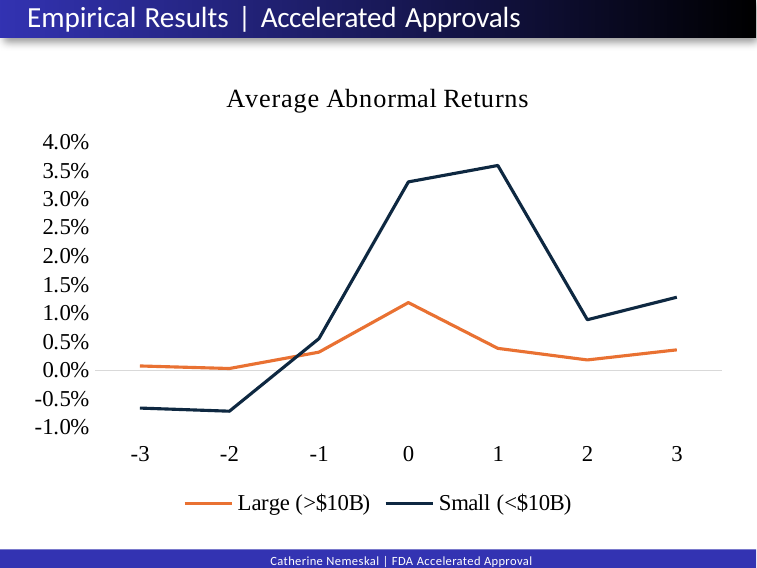
How many series does the legend list? 2 What kind of chart is shown on the slide? line chart Is the value for Large (>$10B) at x = 0 greater or less than 1.0%? greater How many points are plotted along the x axis for each series? 7 At which x-axis value does the Small (<$10B) series reach its highest point? 1 Does the Small (<$10B) series rise or fall between x = -2 and x = 1? rise What is the title of the chart? Average Abnormal Returns At which x-axis value does the Large (>$10B) series reach its highest point? 0 At x = 0, which series has the larger value, Large (>$10B) or Small (<$10B)? Small (<$10B) Is the value for Small (<$10B) at x = -3 greater or less than 0.0%? less Is the value for Small (<$10B) at x = 0 greater or less than 3.0%? greater